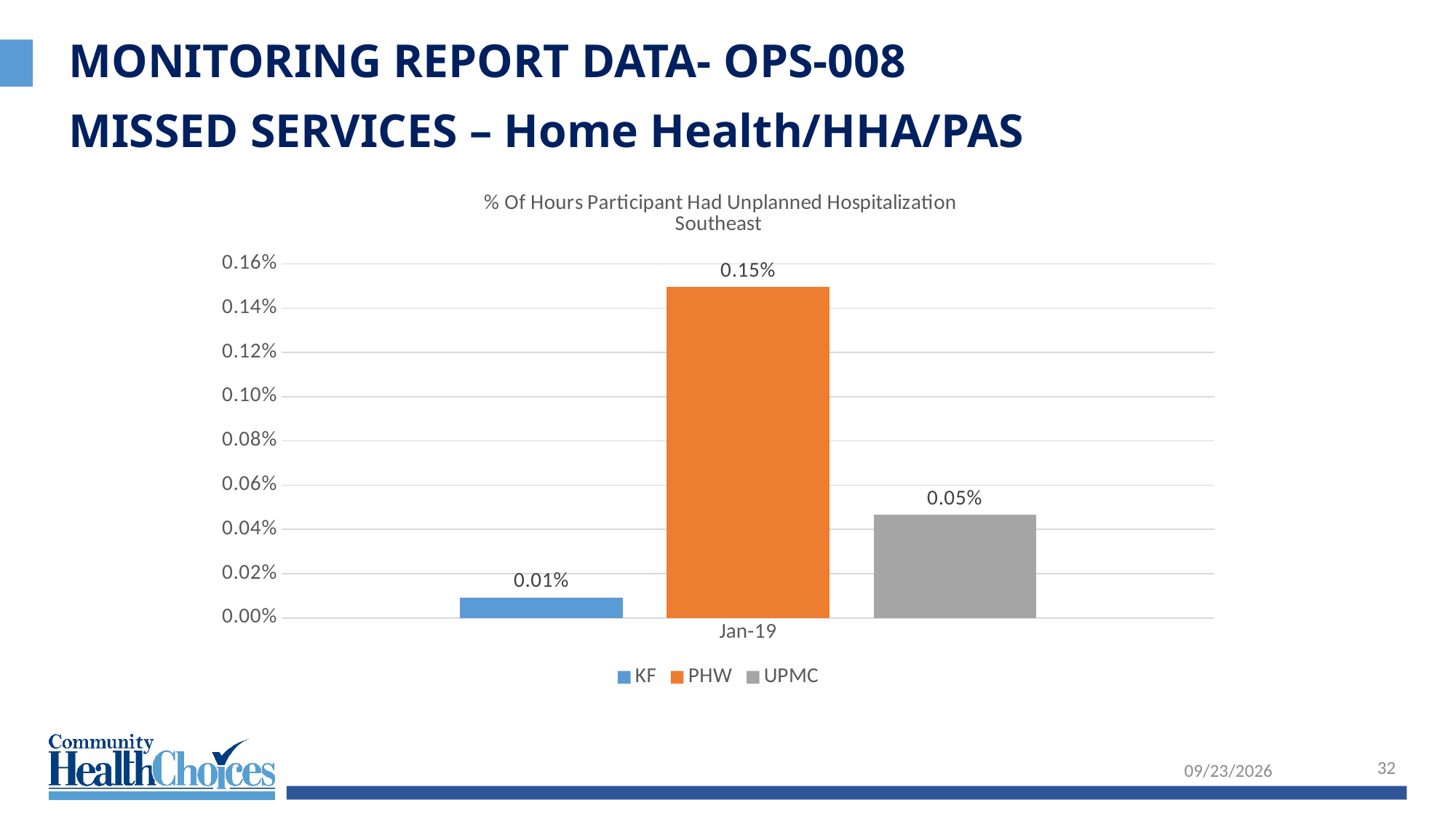
Which series has the lowest value in Jan-19? KF What colour is the bar for PHW? Orange What is the value for UPMC in Jan-19? 0.05% How many series does the legend list? 3 Which series has the highest value in Jan-19? PHW Which is larger in Jan-19, the value for UPMC or the value for KF? UPMC What is the difference between the PHW and UPMC values in Jan-19? 0.10% What is the value for KF in Jan-19? 0.01% What is the value for PHW in Jan-19? 0.15% Is the value for PHW greater or less than 0.10%? greater What kind of chart is shown on the slide? Bar chart Is the value for UPMC greater or less than 0.08%? less